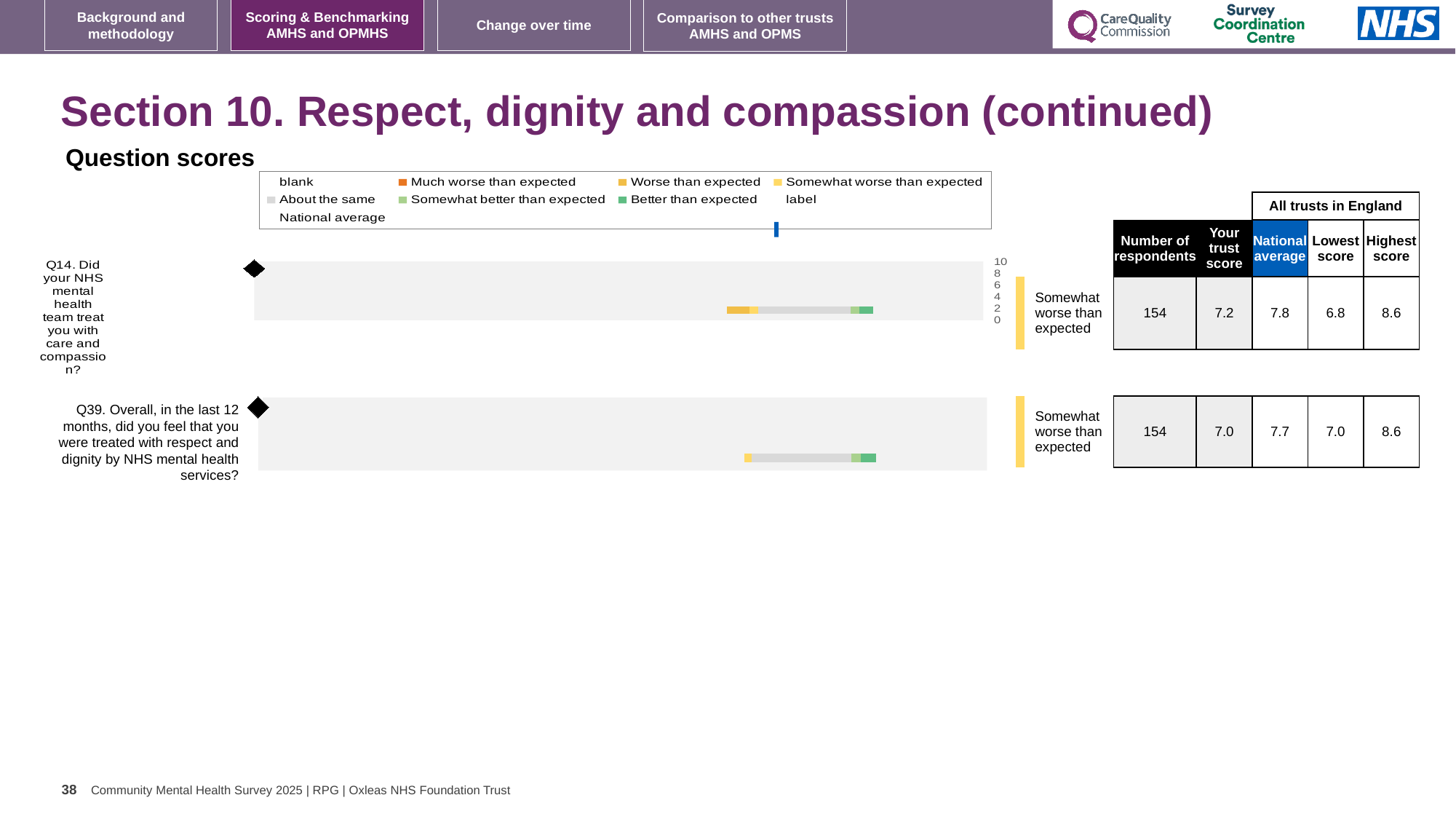
How many questions are plotted in the question scores chart? 2 What is the trust score for Q14 shown in the table next to the chart? 7.2 What is the highest score across all trusts in England for Q14? 8.6 Which is larger for Q39, the trust score or the national average? national average What benchmark category is shown beside the chart for Q14? Somewhat worse than expected How many respondents answered Q14? 154 What is the lowest score across all trusts in England for Q39? 7.0 What is the trust score for Q39 shown in the table next to the chart? 7.0 What is the national average for Q14 shown in the table next to the chart? 7.8 What is the national average for Q39 shown in the table next to the chart? 7.7 What is the difference between the national average and the trust score for Q14? 0.6 What kind of chart is used to show the question scores on this slide? bar chart